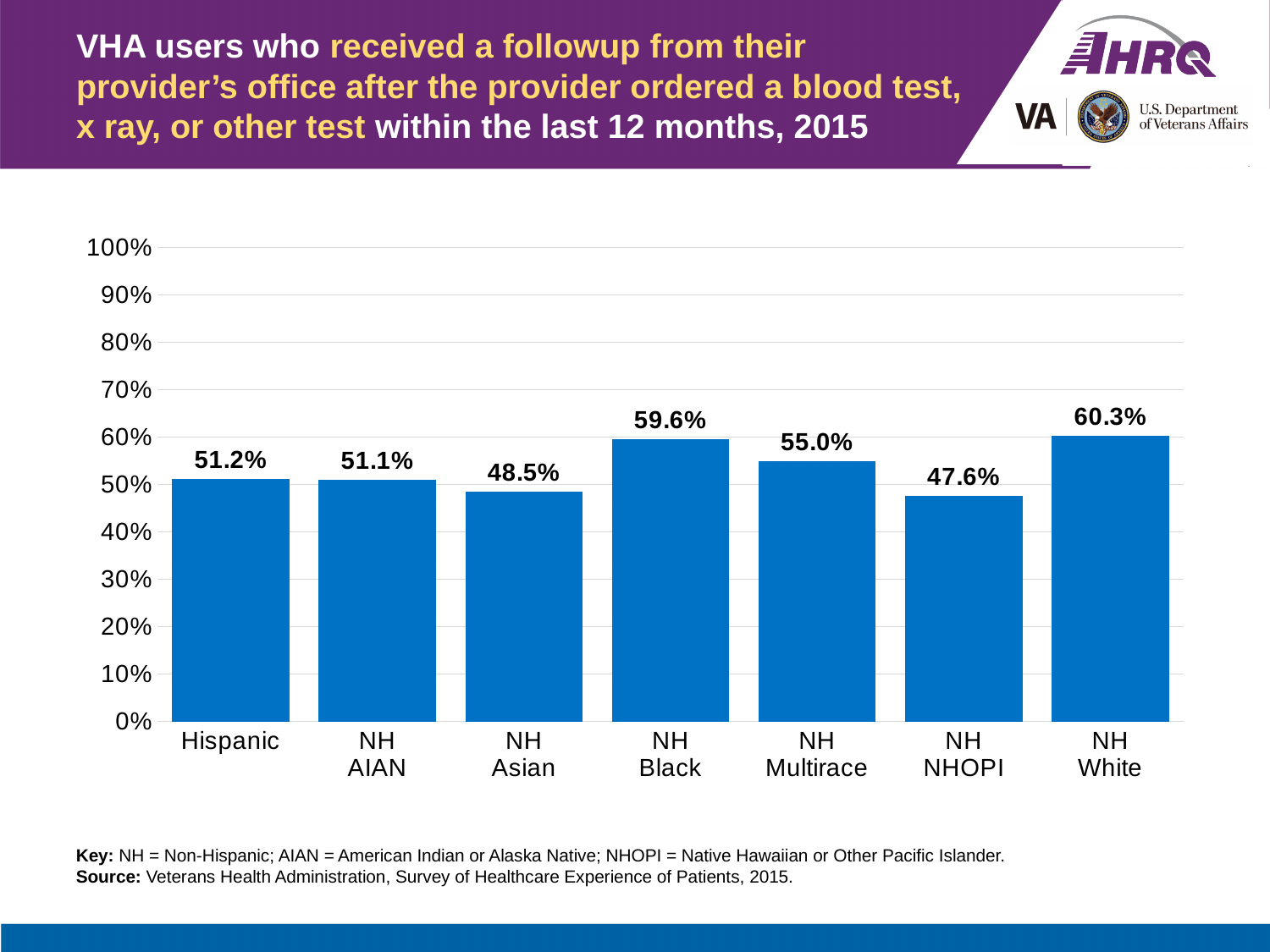
What is the difference between the values for NH White and NH NHOPI? 12.7% What is the difference between the values for NH Black and NH Multirace? 4.6% How many categories are shown on the x axis? 7 What kind of chart is shown on the slide? bar chart Which is larger, the value for NH Multirace or the value for NH Asian? NH Multirace What is the value for Hispanic? 51.2% Is the value for NH White greater or less than 60%? greater What is the value for NH Black? 59.6% What is the value for NH AIAN? 51.1% What is the value for NH NHOPI? 47.6% Which category has the highest value? NH White Which category has the lowest value? NH NHOPI